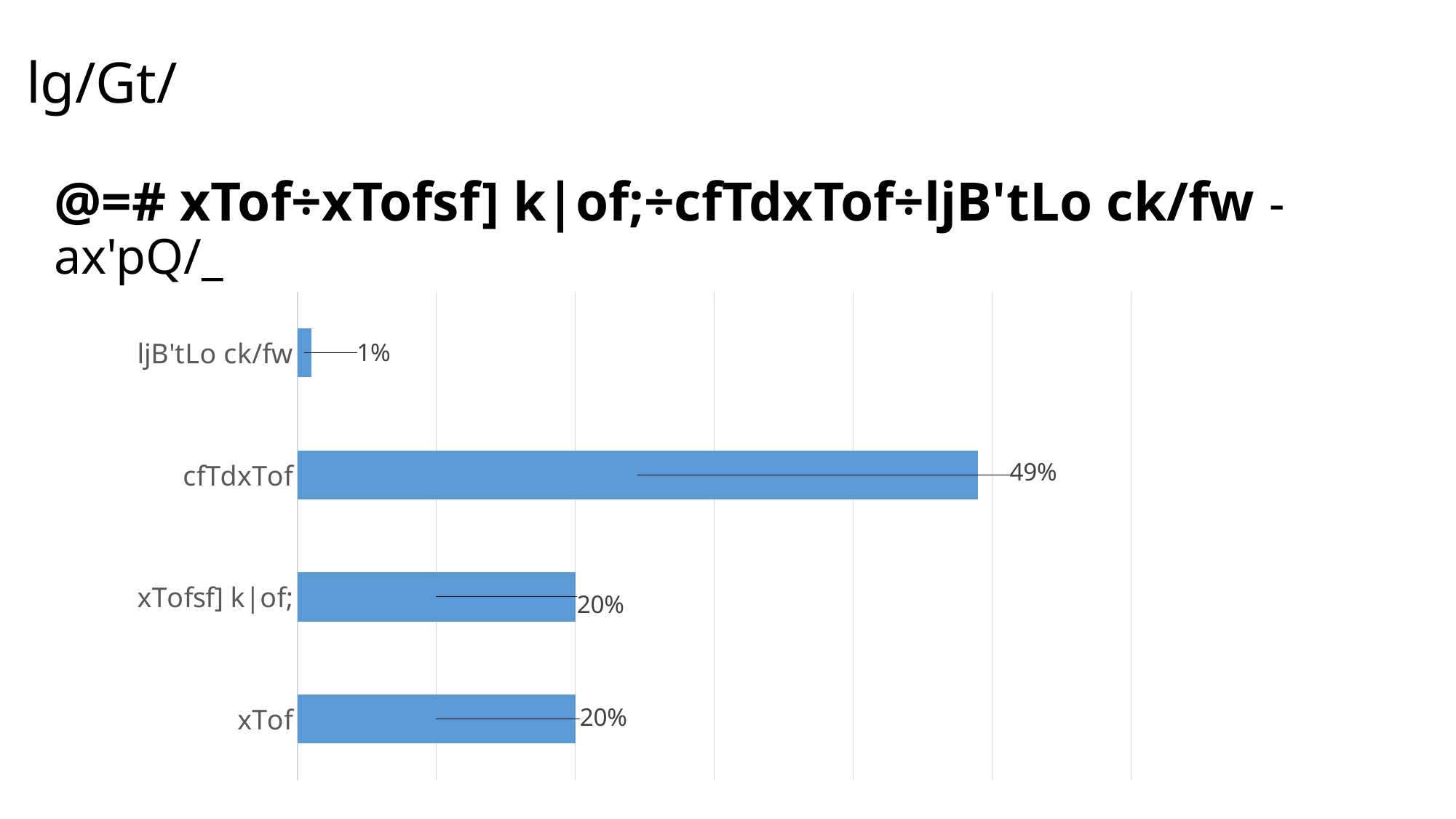
What colour are the bars in the chart? blue What is the difference between the values for xTofsf] k|of; and ljB'tLo ck/fw? 19% What is the value for ljB'tLo ck/fw? 1% How many categories does the bar chart show? 4 Which is larger, the value for cfTdxTof or the value for xTofsf] k|of;? cfTdxTof What is the value for cfTdxTof? 49% Which category has the lowest value? ljB'tLo ck/fw Which category has the highest value? cfTdxTof What is the value for xTofsf] k|of;? 20% What is the difference between the values for cfTdxTof and xTof? 29% What kind of chart is shown on the slide? bar chart What is the value for xTof? 20%